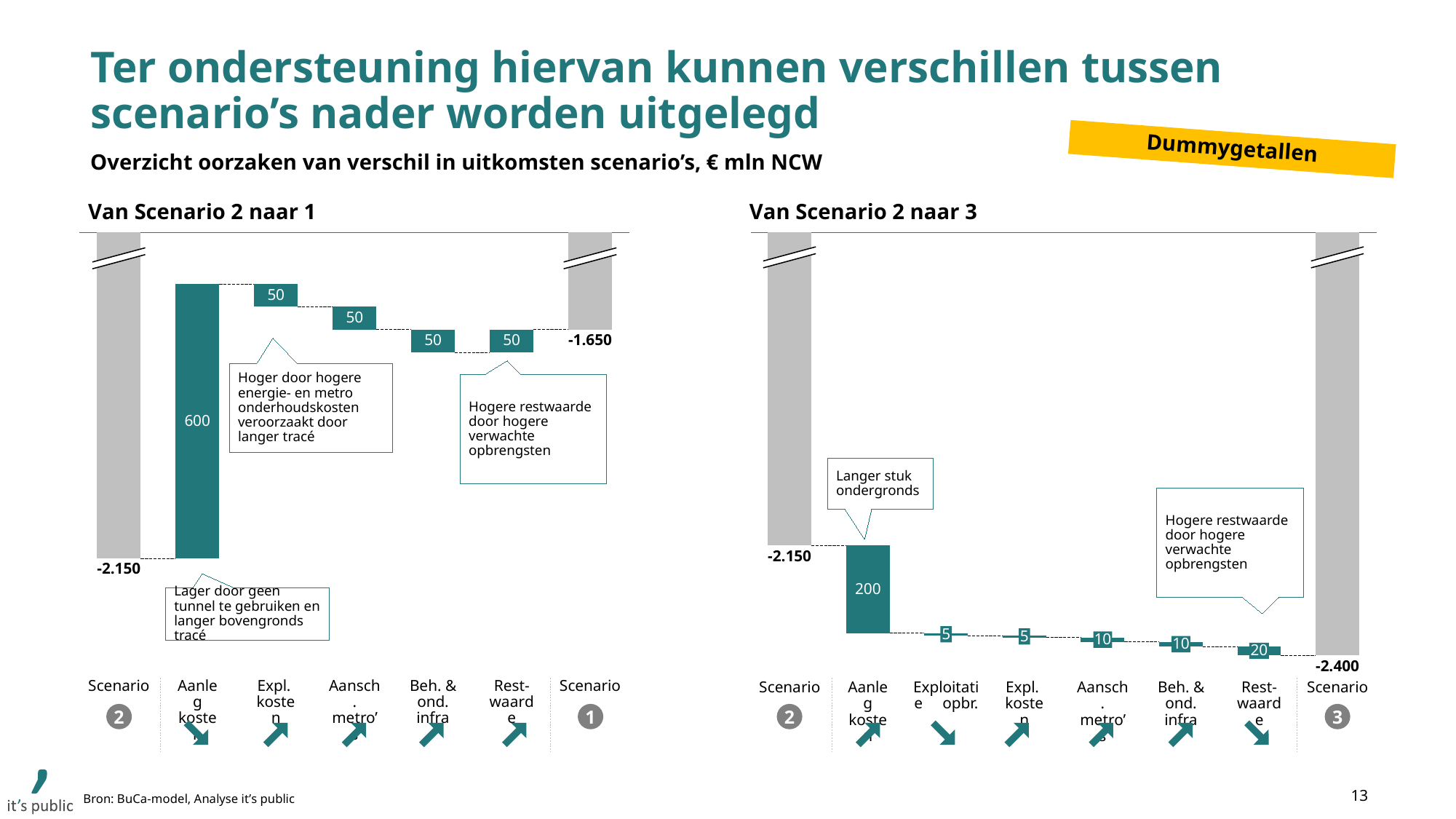
In the 'Van Scenario 2 naar 1' chart, what value is labelled on the Restwaarde bar? 50 In the 'Van Scenario 2 naar 1' chart, what value is labelled on the Aanleg kosten bar? 600 How many categories are shown along the x axis of the 'Van Scenario 2 naar 3' chart? 8 In the 'Van Scenario 2 naar 3' chart, which is larger: the value for Aansch. metro' or the value for Expl. kosten? Aansch. metro' In the 'Van Scenario 2 naar 3' chart, what is the value shown for Scenario 3? -2.400 In the 'Van Scenario 2 naar 3' chart, what is the difference between the Aanleg kosten value and the Restwaarde value? 180 In the 'Van Scenario 2 naar 1' chart, what is the value shown for Scenario 2? -2.150 What kind of chart is the 'Van Scenario 2 naar 1' chart? Waterfall bar chart In the 'Van Scenario 2 naar 3' chart, what value is labelled on the Aanleg kosten bar? 200 In the 'Van Scenario 2 naar 1' chart, what is the value shown for Scenario 1? -1.650 In the 'Van Scenario 2 naar 1' chart, which step bar has the largest labelled value? Aanleg kosten In the 'Van Scenario 2 naar 3' chart, what value is labelled on the Restwaarde bar? 20